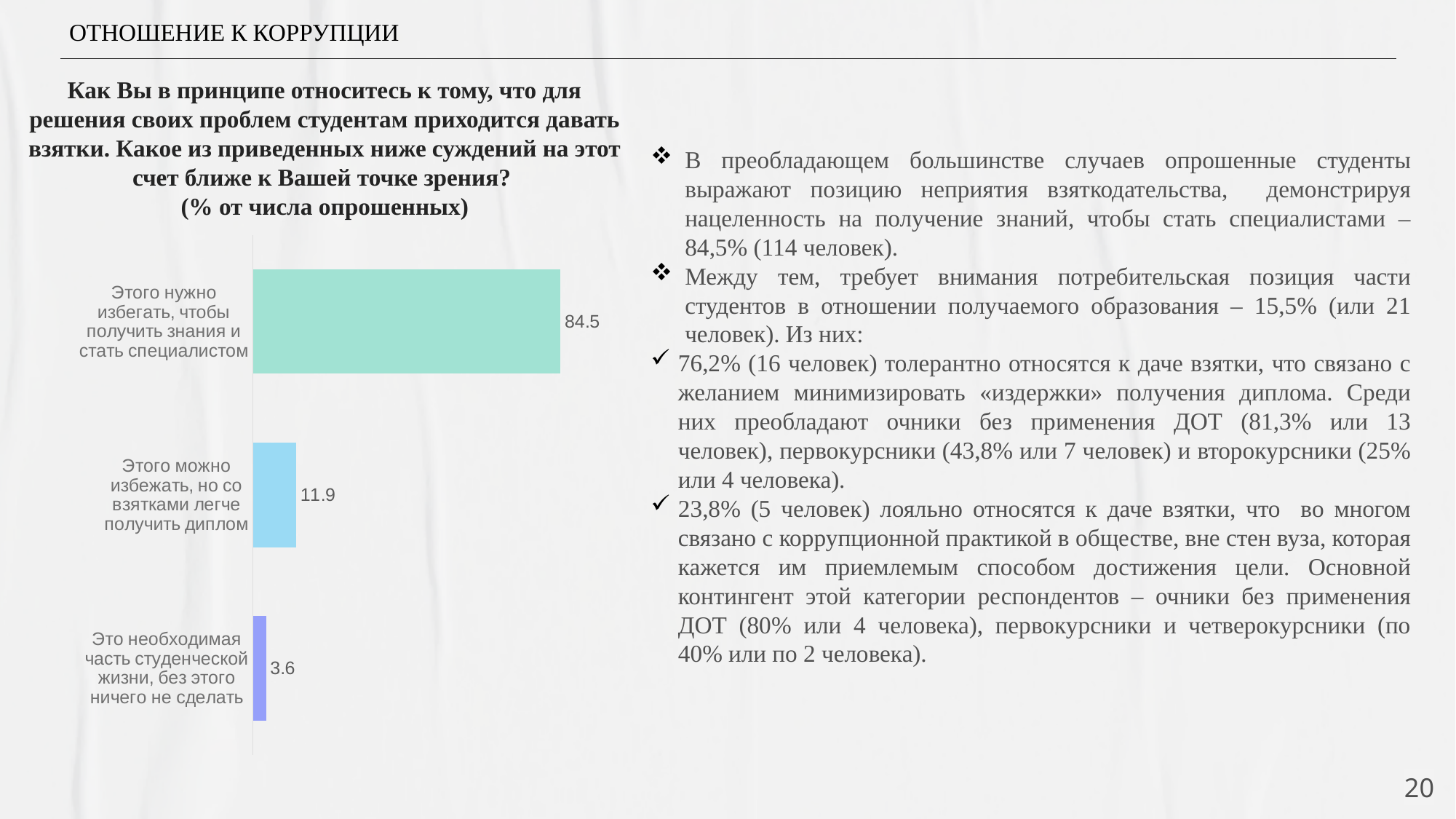
What type of chart is shown on the slide? Bar chart How many categories are shown in the chart? 3 What is the difference between the values for 'Этого можно избежать, но со взятками легче получить диплом' and 'Это необходимая часть студенческой жизни, без этого ничего не сделать'? 8.3 What is the total of the three values shown in the chart? 100 Which is larger: the value for 'Этого можно избежать, но со взятками легче получить диплом' or the value for 'Это необходимая часть студенческой жизни, без этого ничего не сделать'? Этого можно избежать, но со взятками легче получить диплом Which category has the lowest value in the chart? Это необходимая часть студенческой жизни, без этого ничего не сделать What value is shown for the category 'Этого нужно избегать, чтобы получить знания и стать специалистом'? 84.5 What value is shown for the category 'Это необходимая часть студенческой жизни, без этого ничего не сделать'? 3.6 What colour is the bar for 'Этого нужно избегать, чтобы получить знания и стать специалистом'? Light green (mint) What value is shown for the category 'Этого можно избежать, но со взятками легче получить диплом'? 11.9 What is the difference between the values for 'Этого нужно избегать, чтобы получить знания и стать специалистом' and 'Этого можно избежать, но со взятками легче получить диплом'? 72.6 Which category has the highest value in the chart? Этого нужно избегать, чтобы получить знания и стать специалистом